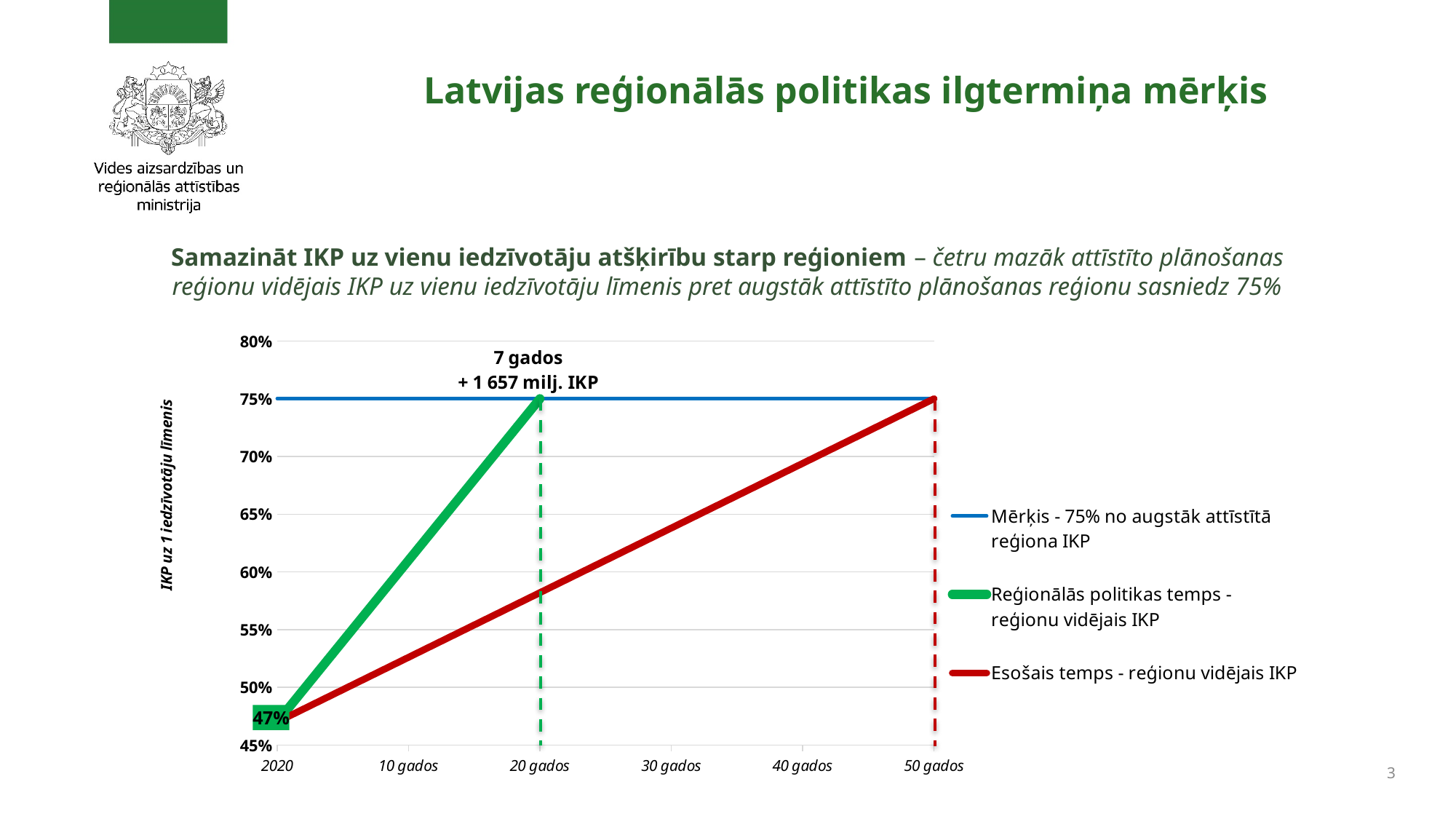
At which x-axis point does the red line (Esošais temps) reach the 75% target? 50 gados At 10 gados, which line is higher: the green line (Reģionālās politikas temps) or the red line (Esošais temps)? the green line (Reģionālās politikas temps) What annotation text is printed above the point where the green line reaches the target? 7 gados + 1 657 milj. IKP Is the value of the red line (Esošais temps) at 40 gados greater or less than 65%? greater At which x-axis point does the green line (Reģionālās politikas temps) reach the 75% target? 20 gados What level does the blue target line (Mērķis) sit at? 75% What is the difference between the 75% target and the 47% starting value? 28 percentage points How many series does the chart legend list? 3 What is the starting value of the regional average GDP per capita level in 2020? 47% What type of chart is shown on the slide? line chart Does the green line (Reģionālās politikas temps) rise or fall along the x axis? rise How many tick labels are shown on the x axis? 6